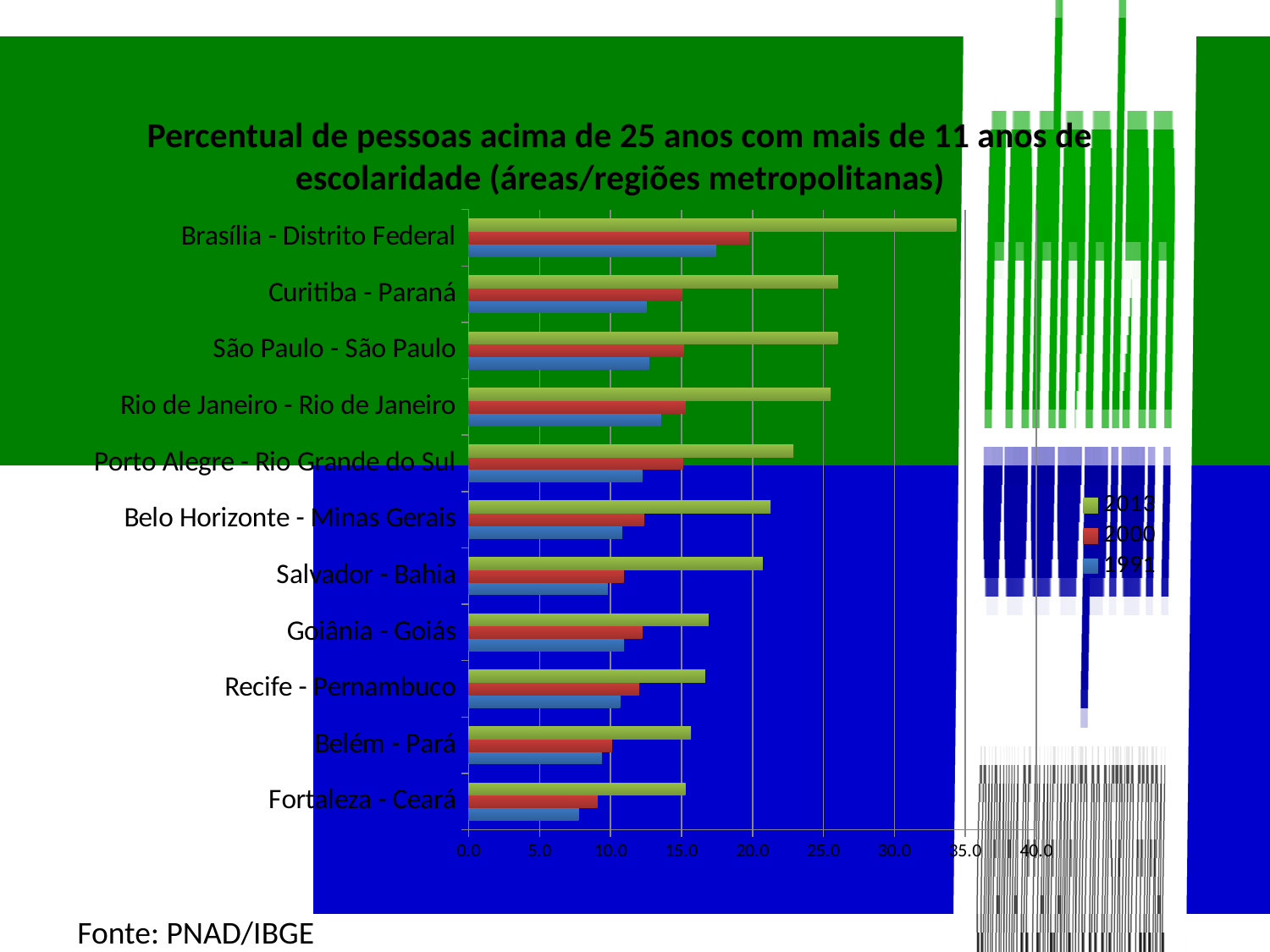
Which years are listed in the chart legend? 2013, 2000, 1991 Is the 2013 value for Porto Alegre - Rio Grande do Sul greater or less than 25.0? less Is the 1991 value for Fortaleza - Ceará greater or less than 10.0? less Which metropolitan area has the lowest 2013 value? Fortaleza - Ceará How many metropolitan areas are listed on the chart? 11 What kind of chart is shown on the slide? bar chart Which is larger, the 2013 value for Brasília - Distrito Federal or the 2013 value for Curitiba - Paraná? Brasília - Distrito Federal Do the 2013 values rise or fall going down the list from Brasília - Distrito Federal to Fortaleza - Ceará? fall Is the 2013 value for Brasília - Distrito Federal greater or less than 30.0? greater How many series does the legend list? 3 Which metropolitan area has the highest 2013 value? Brasília - Distrito Federal